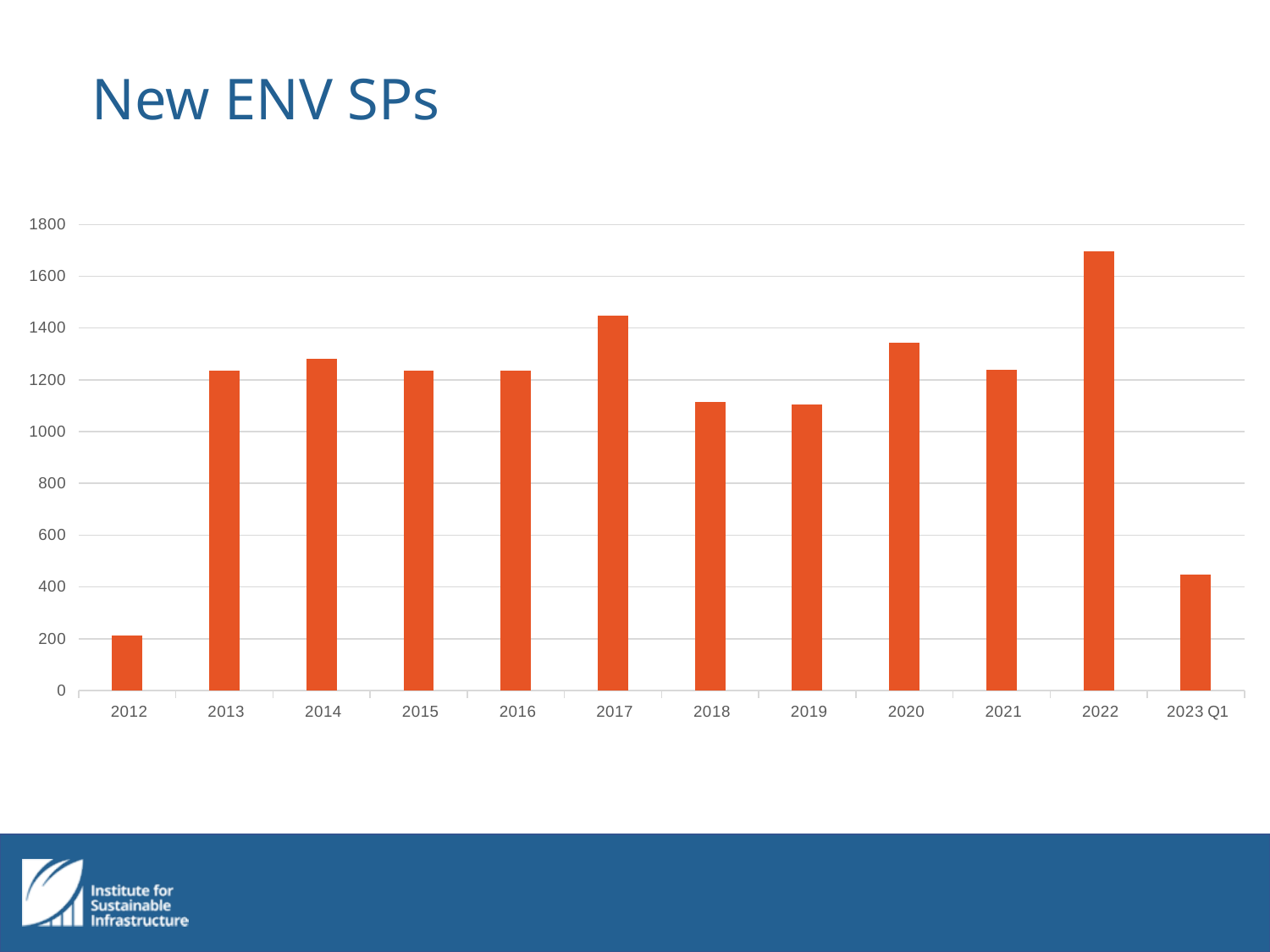
Is the value for 2022 greater or less than 1600? greater Which category has the lowest value? 2012 Which is larger, the value for 2012 or the value for 2023 Q1? 2023 Q1 Which year has the highest number of new ENV SPs? 2022 What kind of chart is shown on the slide? bar chart Is the value for 2012 greater or less than 400? less How many categories are shown on the x axis? 12 What is the title of the chart? New ENV SPs Which is larger, the value for 2017 or the value for 2020? 2017 Is the value for 2018 greater or less than 1200? less